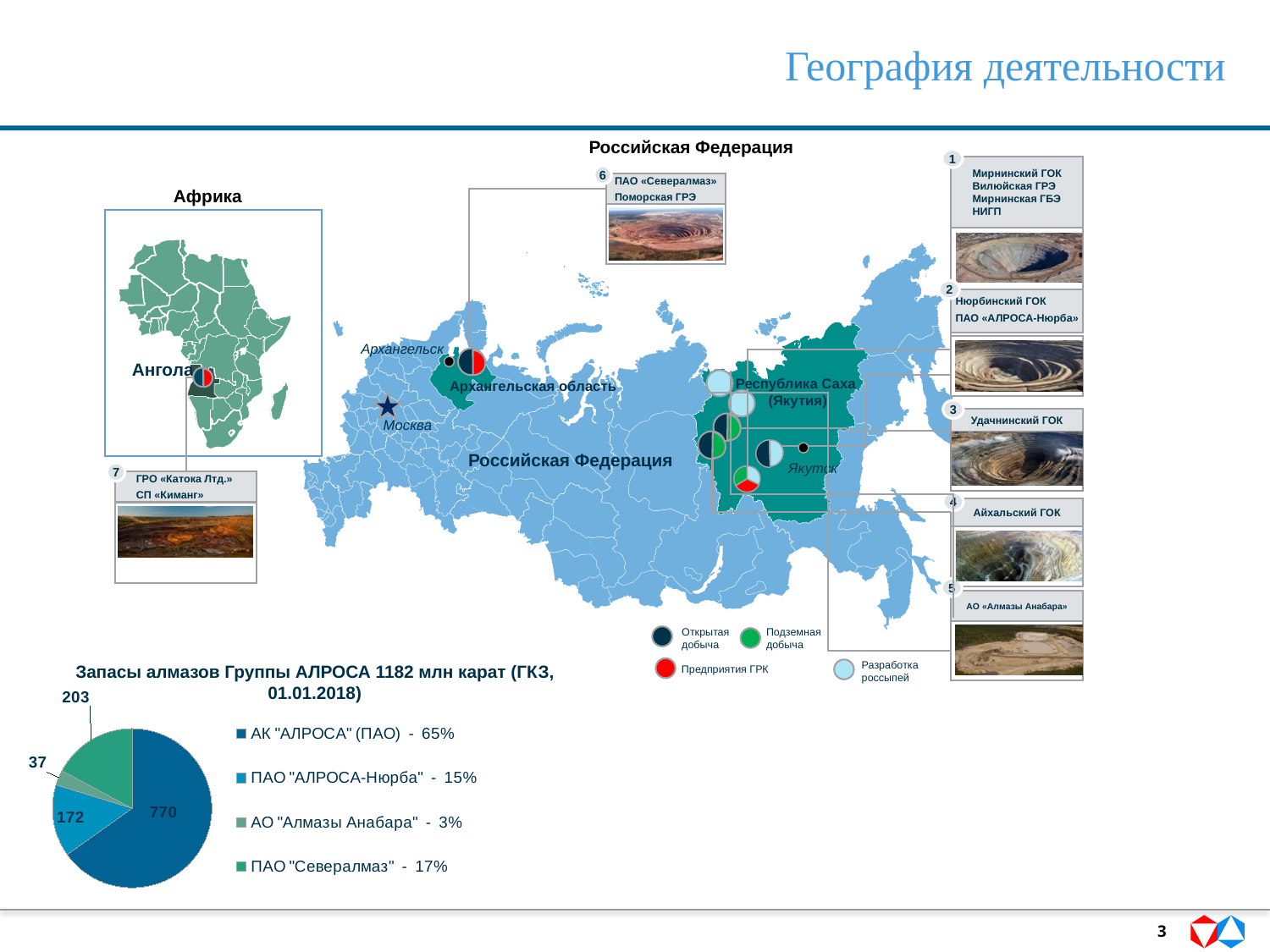
What is the difference between the values for ПАО "Севералмаз" and ПАО "АЛРОСА-Нюрба" in the pie chart? 31 What value is labelled on the pie slice for АО "Алмазы Анабара"? 37 What share of the pie does ПАО "Севералмаз" hold according to the legend? 17% What kind of chart is shown at the bottom left of the slide? pie chart Which company has the largest slice of the pie chart? АК "АЛРОСА" (ПАО) Which is larger in the pie chart: the value for ПАО "Севералмаз" or the value for ПАО "АЛРОСА-Нюрба"? ПАО "Севералмаз" What value is labelled on the pie slice for ПАО "Севералмаз"? 203 How many slices does the pie chart have? 4 What value is labelled on the pie slice for АК "АЛРОСА" (ПАО)? 770 What value is labelled on the pie slice for ПАО "АЛРОСА-Нюрба"? 172 What is the title of the pie chart? Запасы алмазов Группы АЛРОСА 1182 млн карат (ГКЗ, 01.01.2018) Which company has the smallest slice of the pie chart? АО "Алмазы Анабара"